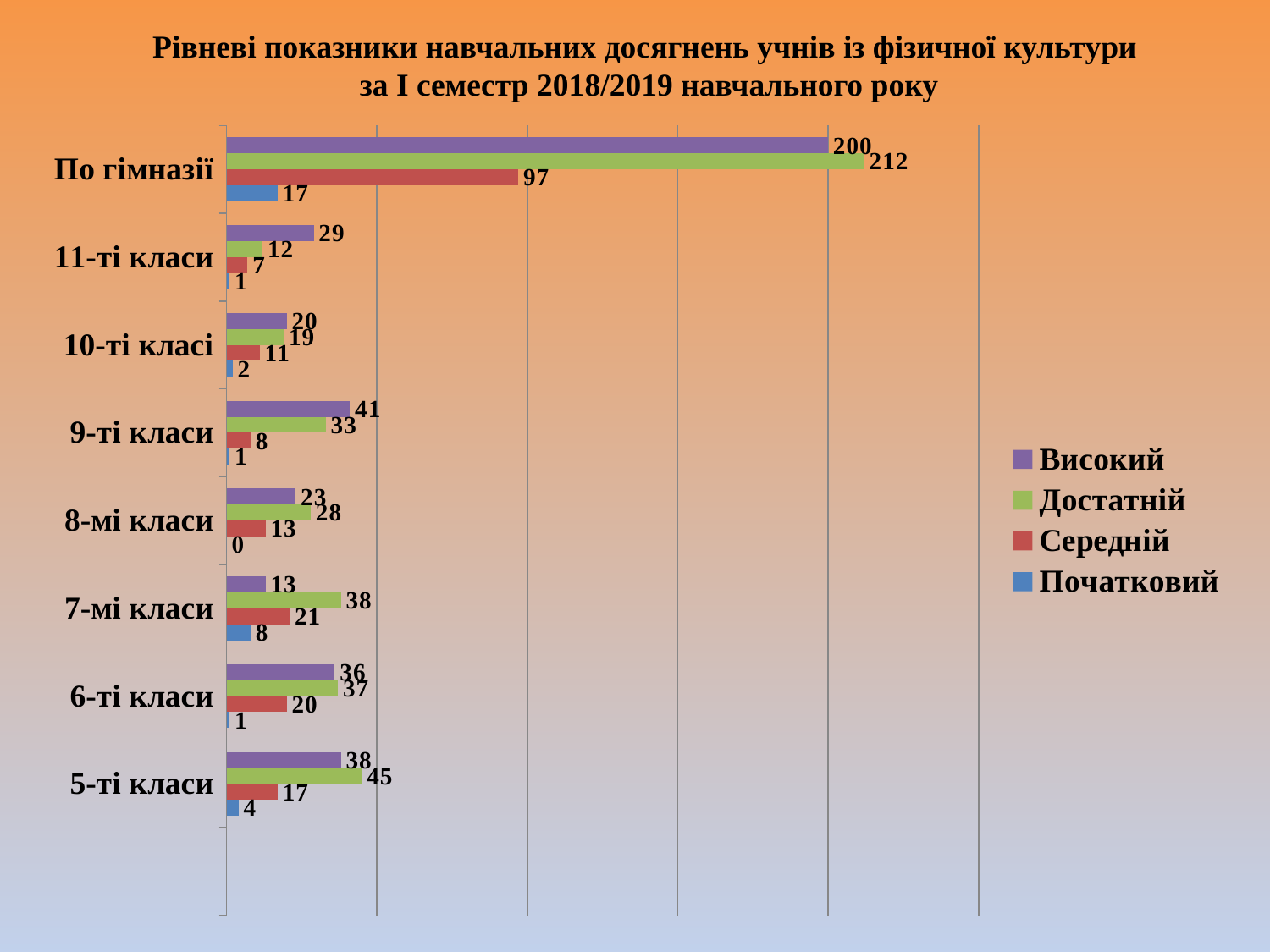
What is the value of Початковий for 5-ті класи? 4 Which category has the lowest Початковий value? 8-мі класи Which is larger for 6-ті класи: Високий or Середній? Високий What is the value of Середній for 7-мі класи? 21 How many series does the legend list? 4 Which series is shown in green in the legend? Достатній What kind of chart is shown on the slide? bar chart What is the difference between the Достатній and Високий values for По гімназії? 12 What is the value of Високий for 9-ті класи? 41 How many categories are shown on the vertical axis? 8 What is the value of Достатній for По гімназії? 212 Among the class categories (excluding По гімназії), which has the highest Достатній value? 5-ті класи